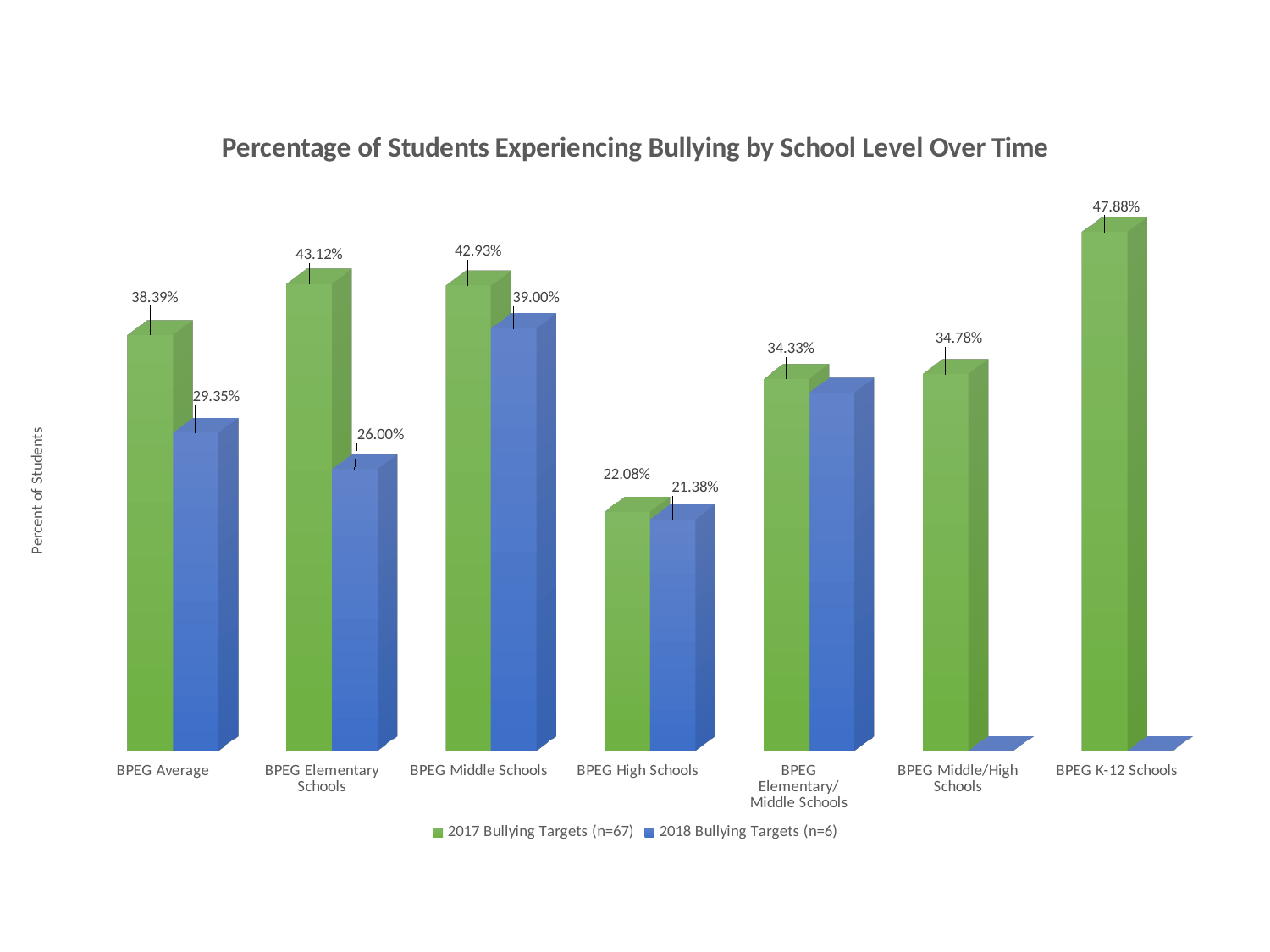
Which school level has the lowest 2017 Bullying Targets value? BPEG High Schools What is the 2018 Bullying Targets value for BPEG Elementary Schools? 26.00% What is the 2017 Bullying Targets value for BPEG K-12 Schools? 47.88% What is the difference between the 2017 and 2018 Bullying Targets values for BPEG Elementary Schools? 17.12 percentage points How many school level categories are shown on the x axis? 7 Which is larger: the 2017 Bullying Targets value for BPEG Average or for BPEG Middle/High Schools? BPEG Average What is the difference between the 2017 and 2018 Bullying Targets values for BPEG Average? 9.04 percentage points How many series does the legend list? 2 Which school level has the highest 2017 Bullying Targets value? BPEG K-12 Schools What kind of chart is shown on the slide? Bar chart What is the 2017 Bullying Targets value for BPEG Middle/High Schools? 34.78%